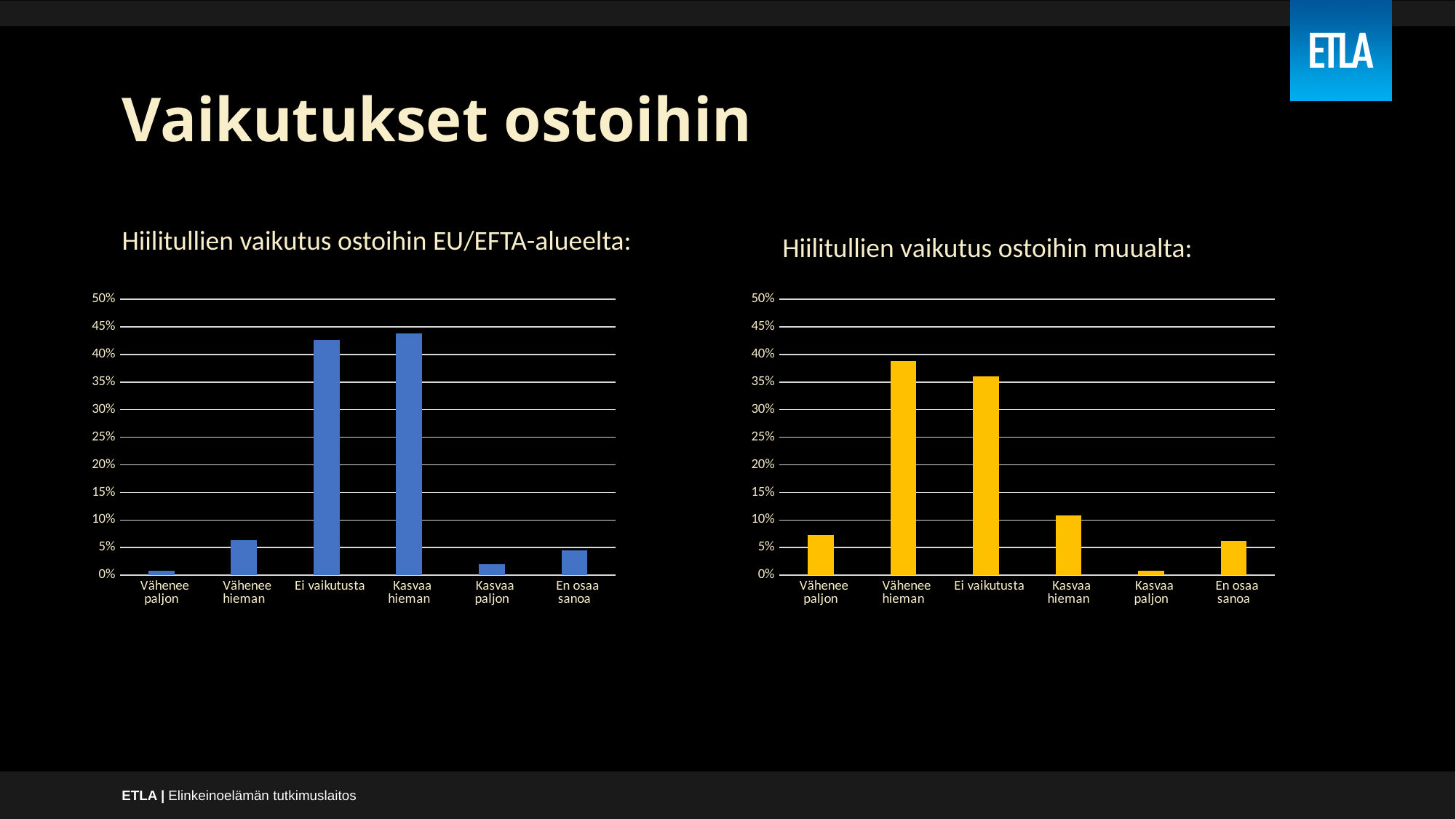
What colour are the bars in the right chart titled 'Hiilitullien vaikutus ostoihin muualta'? Yellow In the left chart (EU/EFTA-alueelta), is the value for Vähenee hieman greater or less than 10%? less In the left chart (EU/EFTA-alueelta), is the value for Ei vaikutusta greater or less than 40%? greater Which is larger: the value for Ei vaikutusta in the left chart (EU/EFTA-alueelta) or in the right chart (muualta)? Left chart (EU/EFTA-alueelta) How many categories are shown on the x axis of the right chart titled 'Hiilitullien vaikutus ostoihin muualta'? 6 In the left chart (EU/EFTA-alueelta), is the value for Kasvaa hieman greater or less than 40%? greater In the right chart (muualta), which category has the highest value? Vähenee hieman What kind of chart is the left chart titled 'Hiilitullien vaikutus ostoihin EU/EFTA-alueelta'? Bar chart In the left chart (EU/EFTA-alueelta), which category has the lowest value? Vähenee paljon In the right chart (muualta), which category has the lowest value? Kasvaa paljon